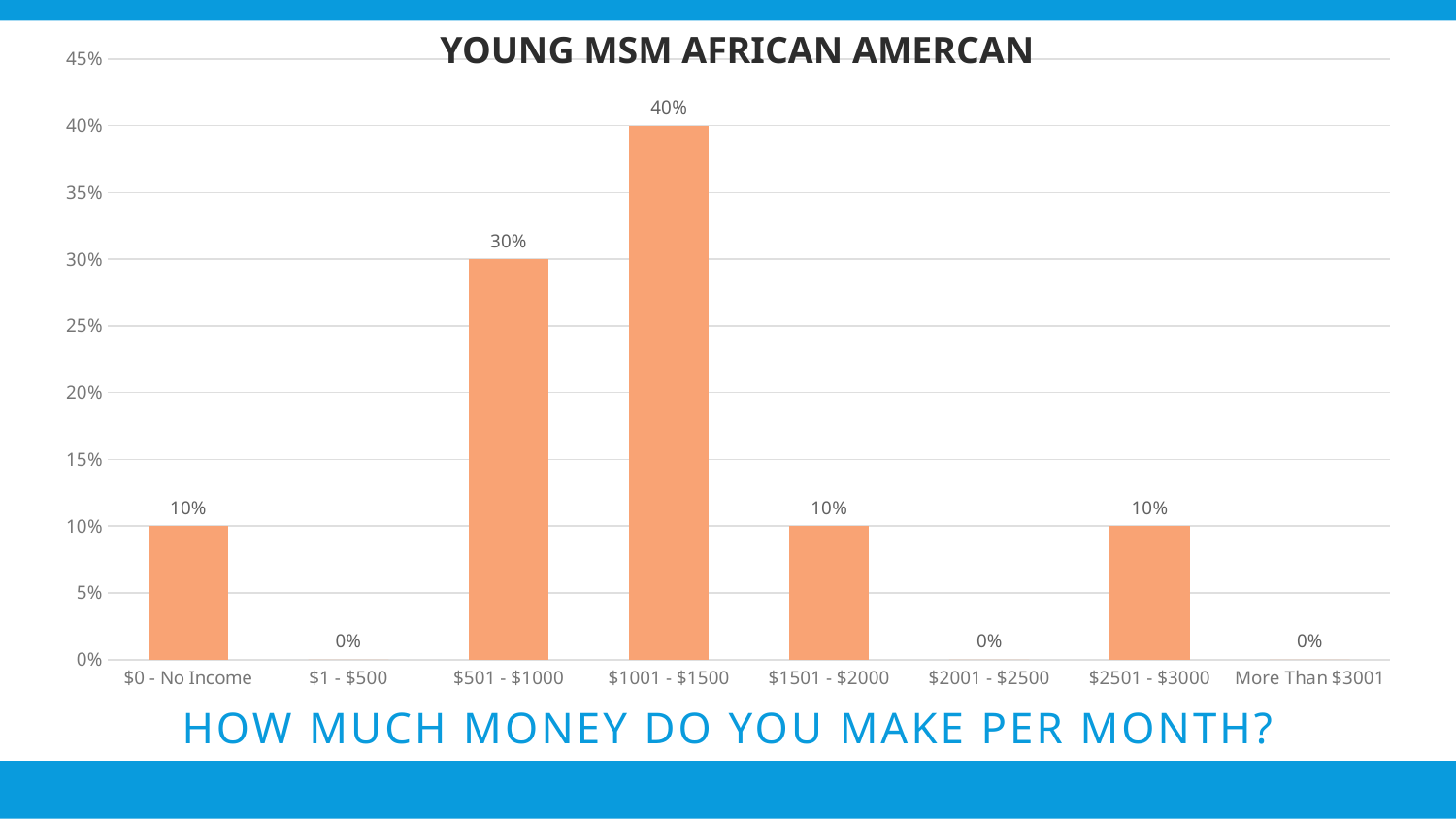
What percentage of respondents reported making $1001 - $1500 per month? 40% What percentage is shown for $0 - No Income? 10% What is the value for the $501 - $1000 category? 30% What is the value for the $2001 - $2500 category? 0% What kind of chart is shown on the slide? bar chart Which is larger, the value for $501 - $1000 or the value for $1501 - $2000? $501 - $1000 How many income categories are shown on the x axis? 8 Is the value for $1001 - $1500 greater or less than 35%? greater What is the title of the chart? YOUNG MSM AFRICAN AMERCAN What is the difference between the $1001 - $1500 and $501 - $1000 values? 10% Which income category has the highest percentage? $1001 - $1500 How many categories have a value of 0%? 3